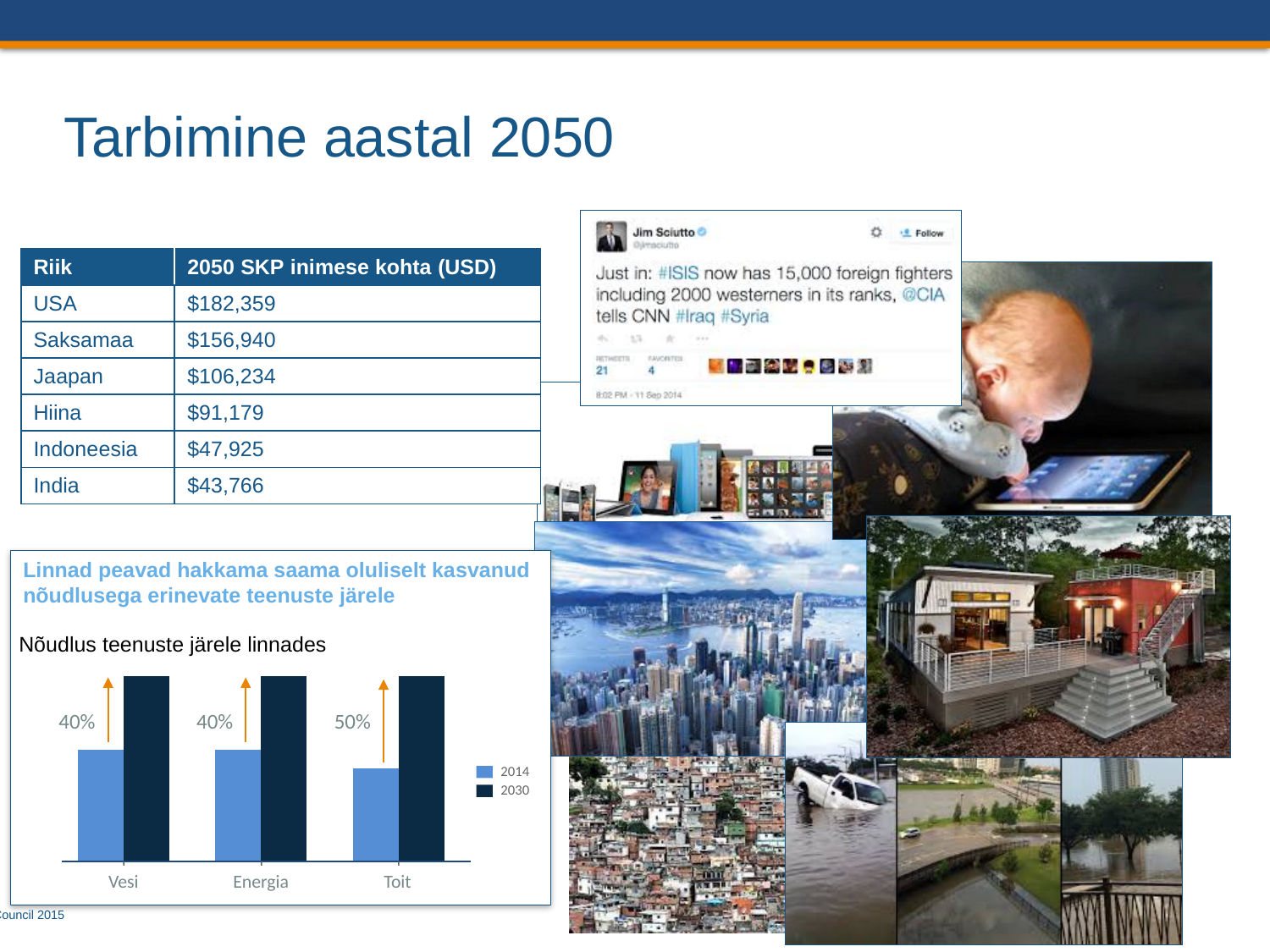
In the 'Nõudlus teenuste järele linnades' chart, what percentage increase is labelled above the Vesi bars? 40% In the 'Nõudlus teenuste järele linnades' chart, which category has the largest labelled percentage increase? Toit How many series does the legend of the 'Nõudlus teenuste järele linnades' chart list? 2 In the 'Nõudlus teenuste järele linnades' chart, which category has the lowest 2014 bar? Toit What are the category labels on the x axis of the 'Nõudlus teenuste järele linnades' chart? Vesi, Energia, Toit How many categories are shown on the x axis of the 'Nõudlus teenuste järele linnades' chart? 3 In the 'Nõudlus teenuste järele linnades' chart, is the 2030 bar for Toit higher or lower than the 2014 bar for Toit? higher What kind of chart is 'Nõudlus teenuste järele linnades'? bar chart In the 'Nõudlus teenuste järele linnades' chart, what percentage increase is labelled above the Toit bars? 50% In the 'Nõudlus teenuste järele linnades' chart, what percentage increase is labelled above the Energia bars? 40% Which two series are listed in the legend of the 'Nõudlus teenuste järele linnades' chart? 2014 and 2030 In the 'Nõudlus teenuste järele linnades' chart, is the 2030 bar for Vesi higher or lower than the 2014 bar for Vesi? higher